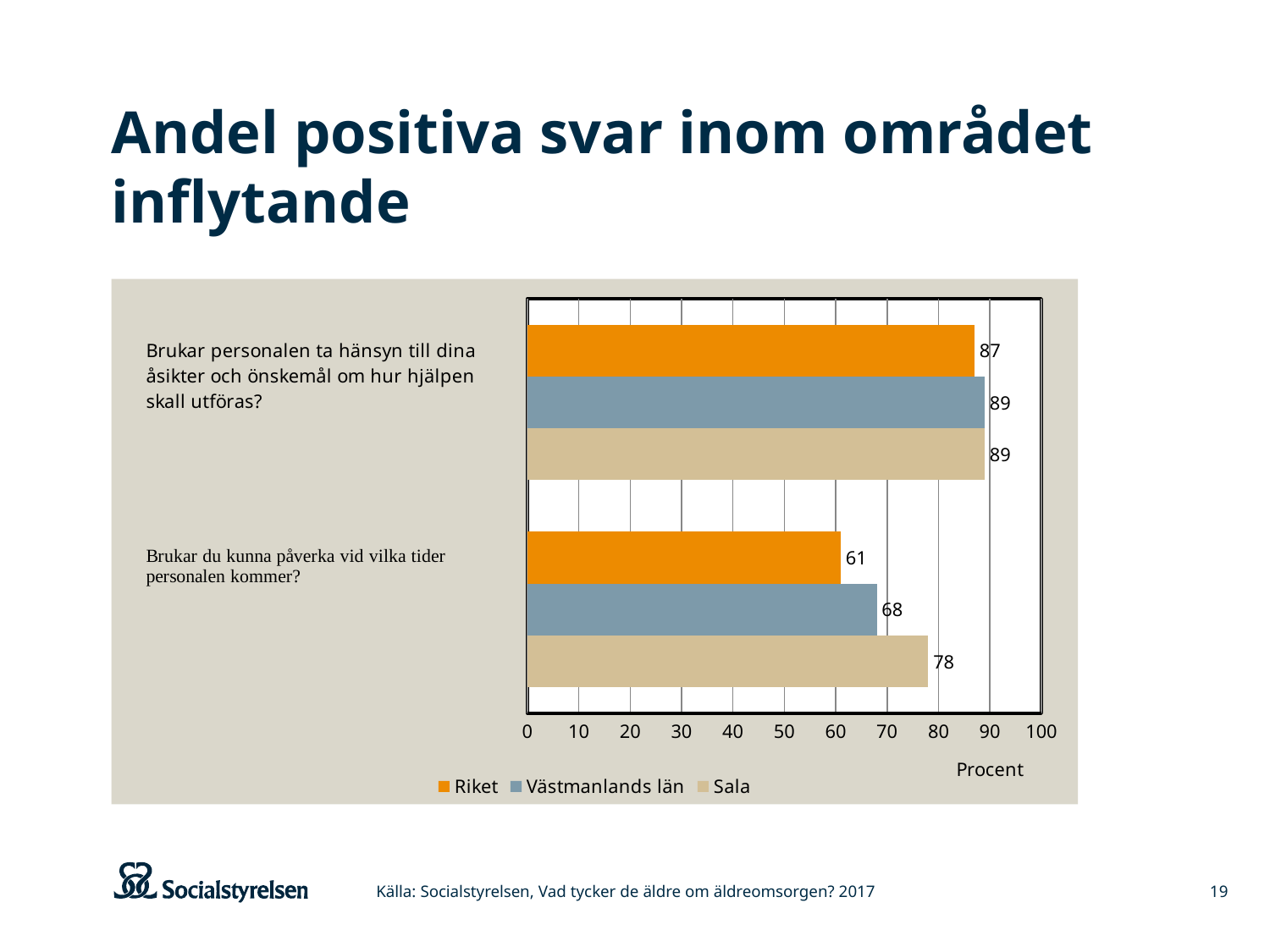
What is the value for Sala on the question "Brukar du kunna påverka vid vilka tider personalen kommer?" 78 What type of chart is shown on the slide? Bar chart What is the value for Riket on the question "Brukar du kunna påverka vid vilka tider personalen kommer?" 61 Which series has the lowest value on the question "Brukar du kunna påverka vid vilka tider personalen kommer?" Riket How many questions (categories) are shown in the chart? 2 What is the difference between Sala and Riket on the question "Brukar du kunna påverka vid vilka tider personalen kommer?" 17 How many series does the legend list? 3 What is the value for Västmanlands län on the question "Brukar personalen ta hänsyn till dina åsikter och önskemål om hur hjälpen skall utföras?" 89 Which is larger on the question "Brukar du kunna påverka vid vilka tider personalen kommer?": Västmanlands län or Riket? Västmanlands län What is the value for Riket on the question "Brukar personalen ta hänsyn till dina åsikter och önskemål om hur hjälpen skall utföras?" 87 What unit is shown on the x axis of the chart? Procent Which series has the highest value on the question "Brukar du kunna påverka vid vilka tider personalen kommer?" Sala